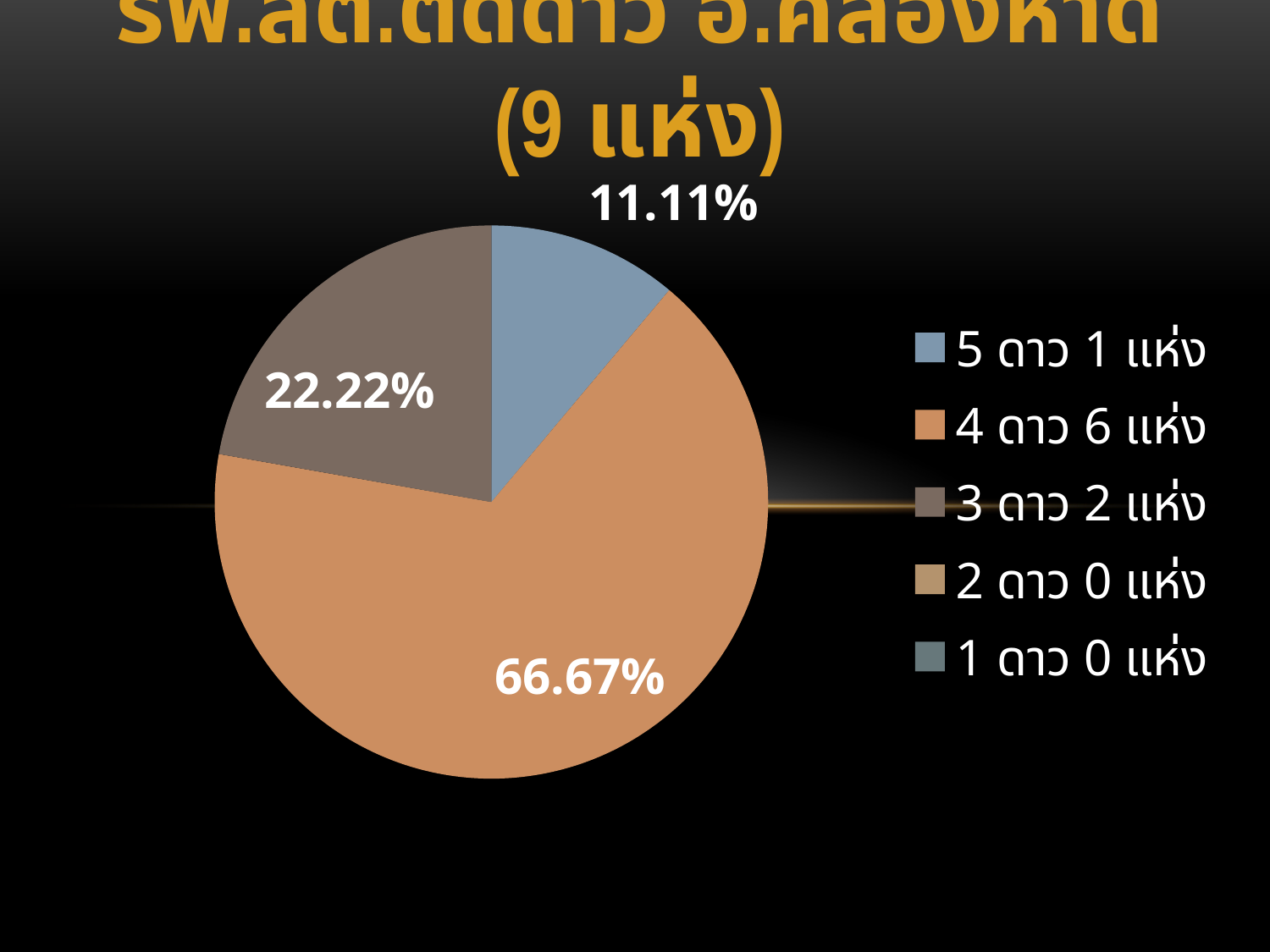
Which category has the largest slice of the pie? 4 ดาว 6 แห่ง What is the difference in percentage points between the 4 ดาว slice and the 3 ดาว slice? 44.45% What percentage of the pie does the 3 ดาว 2 แห่ง slice represent? 22.22% What percentage of the pie does the 4 ดาว 6 แห่ง slice represent? 66.67% According to the legend, how many places have 2 ดาว? 0 แห่ง What kind of chart is shown on the slide? pie chart Which slice is larger, 3 ดาว 2 แห่ง or 5 ดาว 1 แห่ง? 3 ดาว 2 แห่ง What percentage of the pie does the 5 ดาว 1 แห่ง slice represent? 11.11% How many slices with a printed percentage are visible in the pie? 3 What is the difference in percentage points between the 3 ดาว slice and the 5 ดาว slice? 11.11% Which of the slices with a printed percentage is the smallest? 5 ดาว 1 แห่ง How many entries does the legend list? 5